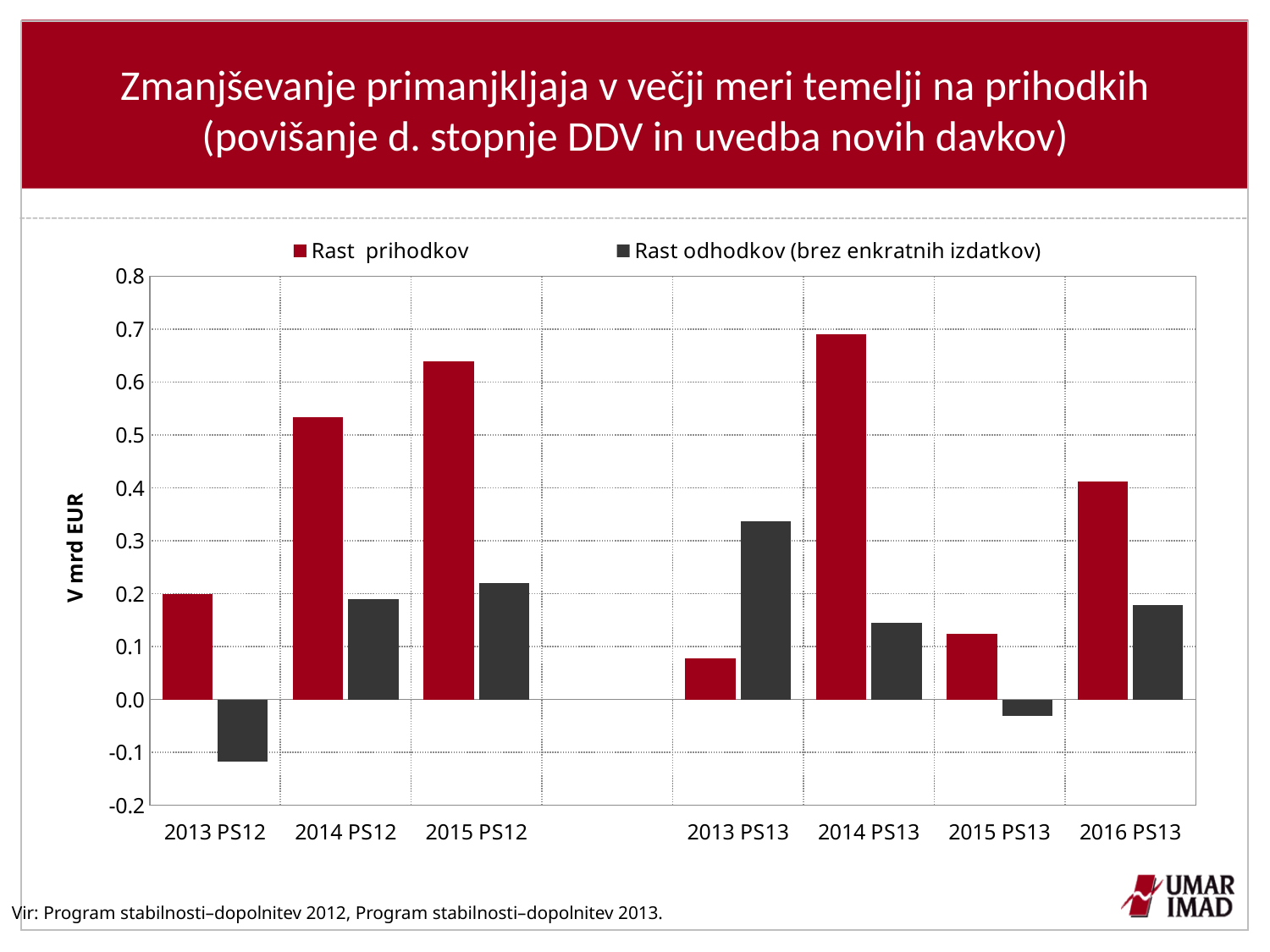
What is the label of the vertical axis? V mrd EUR How many labelled categories are on the x axis? 7 Which category has the highest value for Rast odhodkov (brez enkratnih izdatkov)? 2013 PS13 Is the Rast odhodkov (brez enkratnih izdatkov) value for 2013 PS13 greater or less than 0.3? greater Which category has the lowest value for Rast odhodkov (brez enkratnih izdatkov)? 2013 PS12 How many series does the legend list? 2 Is the Rast odhodkov (brez enkratnih izdatkov) value for 2013 PS12 greater or less than 0.0? less Which category has the lowest value for Rast prihodkov? 2013 PS13 For 2013 PS13, which series has the larger value: Rast prihodkov or Rast odhodkov (brez enkratnih izdatkov)? Rast odhodkov (brez enkratnih izdatkov) Is the Rast prihodkov value for 2015 PS12 greater or less than 0.6? greater What kind of chart is shown on the slide? bar chart Which category has the highest value for Rast prihodkov? 2014 PS13